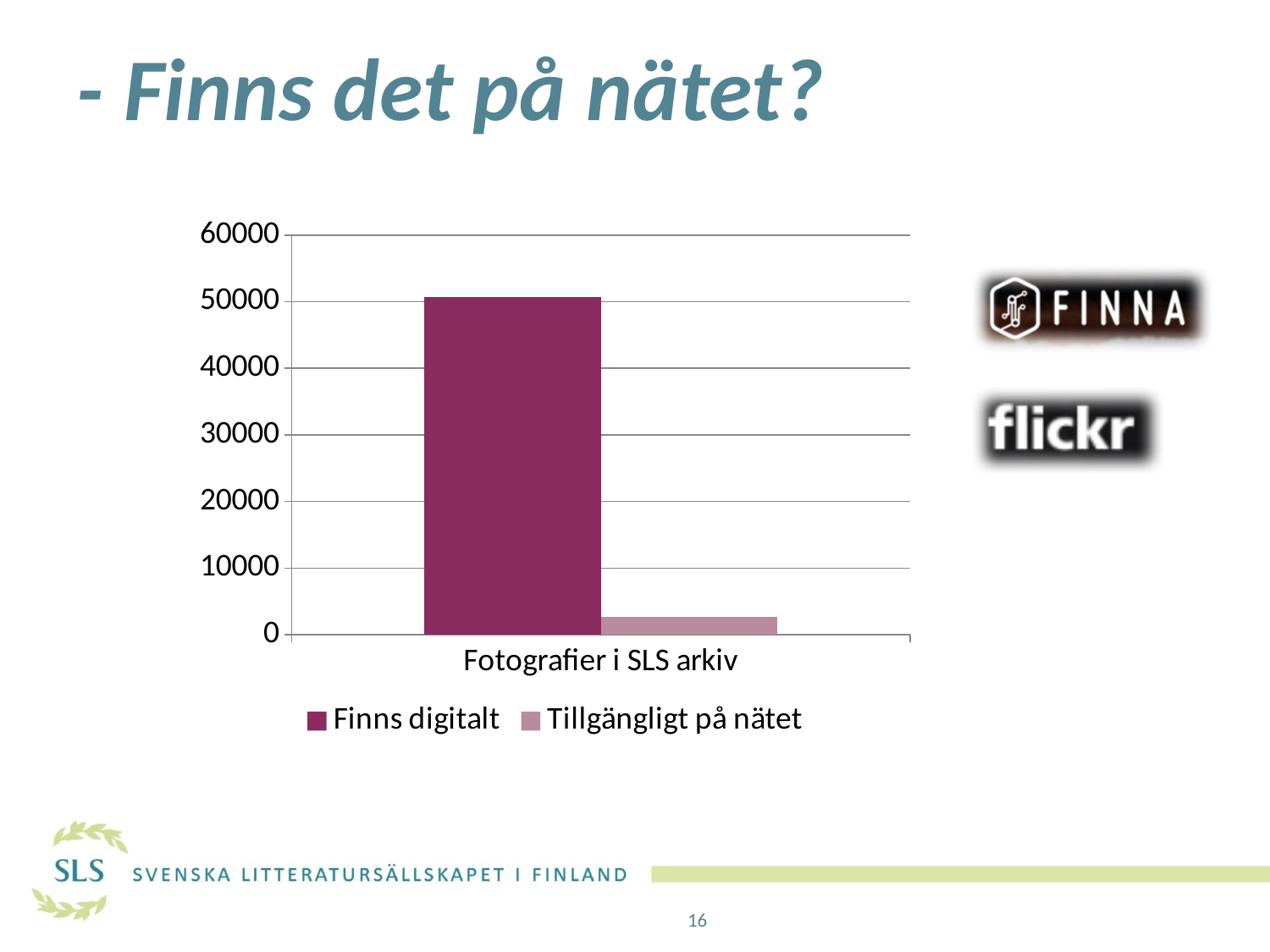
What is the highest value shown on the chart's y axis? 60000 Which series has the higher value for Fotografier i SLS arkiv: Finns digitalt or Tillgängligt på nätet? Finns digitalt What is the category label shown on the x axis of the chart? Fotografier i SLS arkiv Is the value for Tillgängligt på nätet greater or less than 10000? less Which series has the highest value in the chart? Finns digitalt Is the value for Finns digitalt greater or less than 40000? greater What kind of chart is shown on the slide? bar chart Is the value for Finns digitalt greater or less than 60000? less Which series has the lowest value in the chart? Tillgängligt på nätet How many categories are shown on the x axis of the chart? 1 How many series does the chart legend list? 2